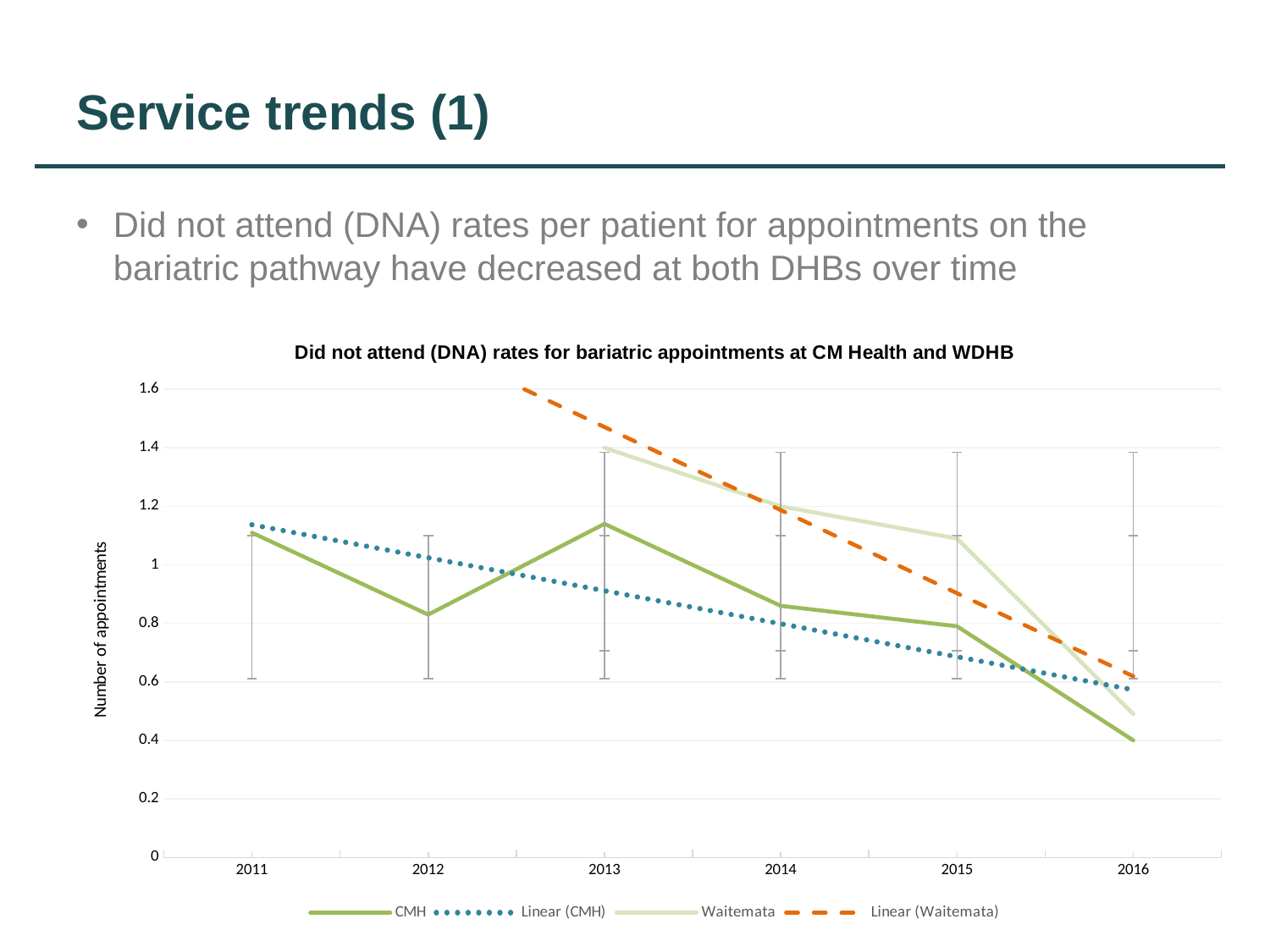
For the CMH series, which year has the higher value, 2012 or 2013? 2013 Is the CMH value for 2012 greater or less than 1? less How many series does the chart legend list? 4 Is the Waitemata value for 2014 greater or less than 1? greater In 2014, which series has the higher value, CMH or Waitemata? Waitemata What is the label on the y axis of the chart? Number of appointments In which year is the CMH series at its lowest value? 2016 What kind of chart is shown on the slide? Line chart Is the CMH value for 2016 greater or less than 0.6? less Does the CMH series rise or fall from 2013 to 2016? Fall How many years are shown on the x axis of the chart? 6 What is the title of the chart? Did not attend (DNA) rates for bariatric appointments at CM Health and WDHB